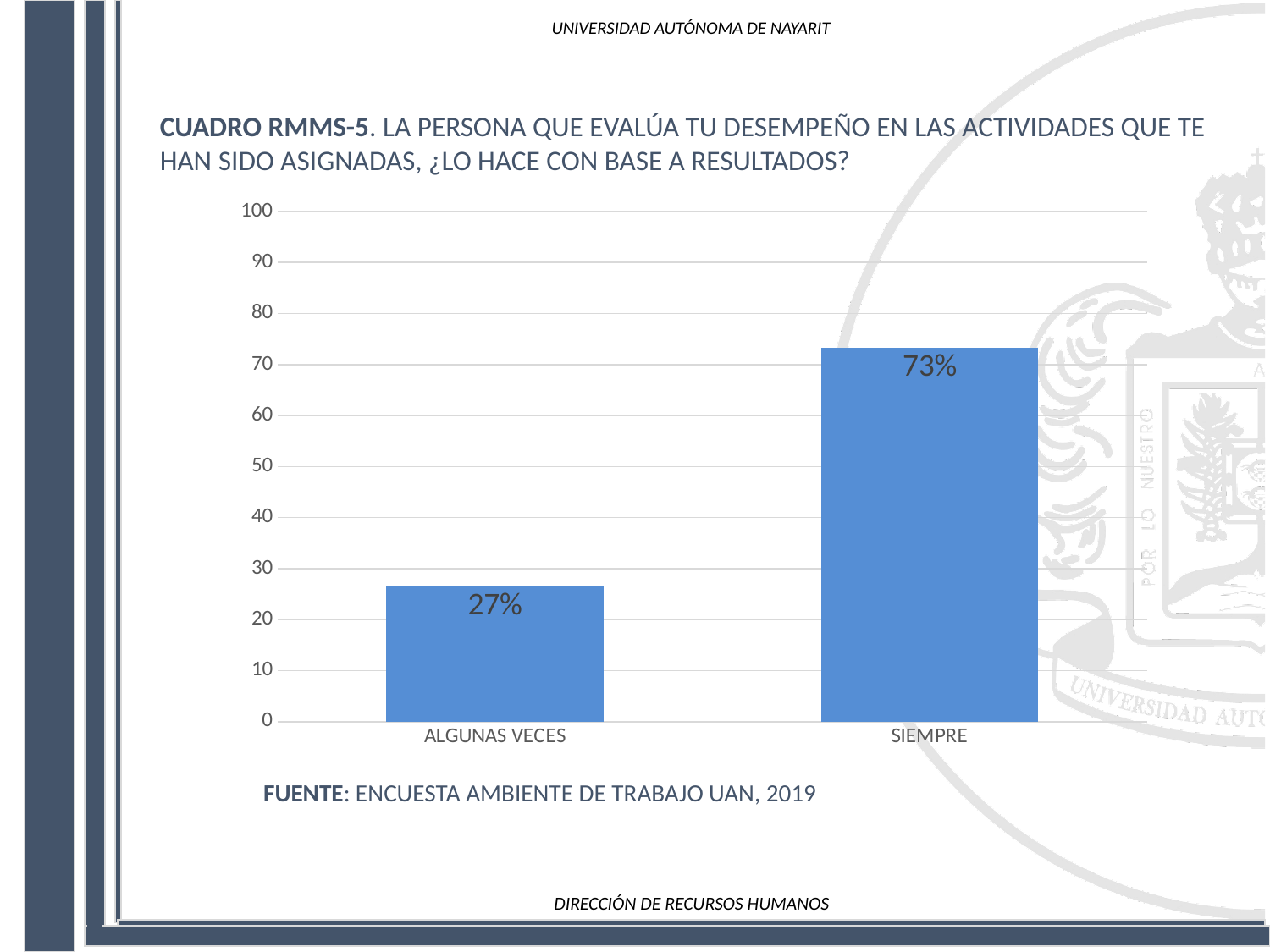
Which is larger, the value for ALGUNAS VECES or the value for SIEMPRE? SIEMPRE What is the difference between the values for SIEMPRE and ALGUNAS VECES? 46% What kind of chart is shown on the slide? bar chart Is the value for ALGUNAS VECES greater or less than 40? less What is the maximum value shown on the y axis? 100 What is the value for SIEMPRE? 73% Which category has the lowest value? ALGUNAS VECES What is the value for ALGUNAS VECES? 27% How many categories are shown on the x axis? 2 Is the value for SIEMPRE greater or less than 50? greater What is the source cited below the chart? ENCUESTA AMBIENTE DE TRABAJO UAN, 2019 Which category has the highest value? SIEMPRE